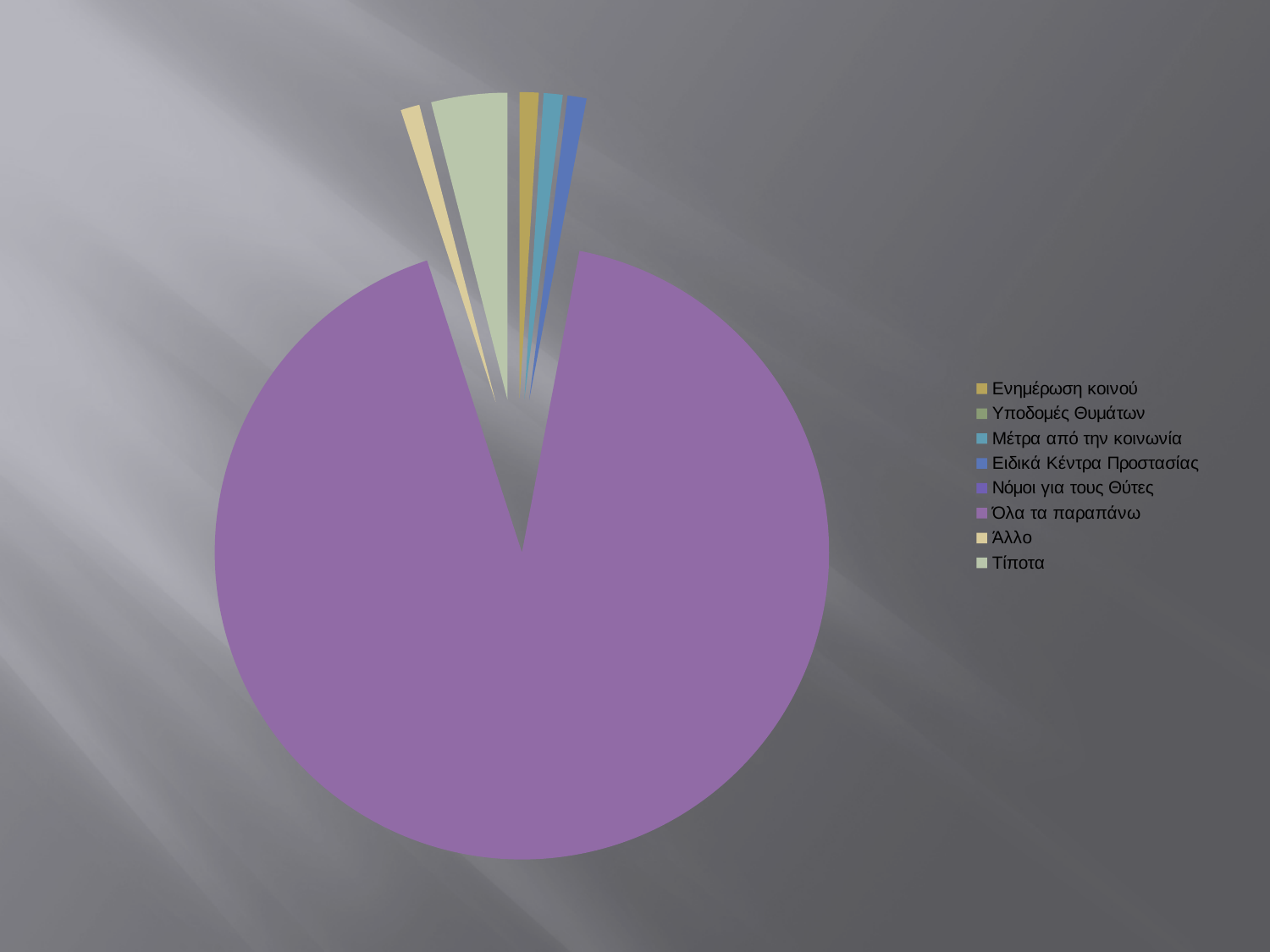
What colour is the largest slice of the pie? purple Does the slice for Όλα τα παραπάνω take up more or less than half of the pie? more Which legend entry is listed first? Ενημέρωση κοινού Which category has the largest slice of the pie? Όλα τα παραπάνω Which is larger, the slice for Όλα τα παραπάνω or the slice for Υποδομές Θυμάτων? Όλα τα παραπάνω How many entries does the legend list? 8 What kind of chart is shown on the slide? pie chart